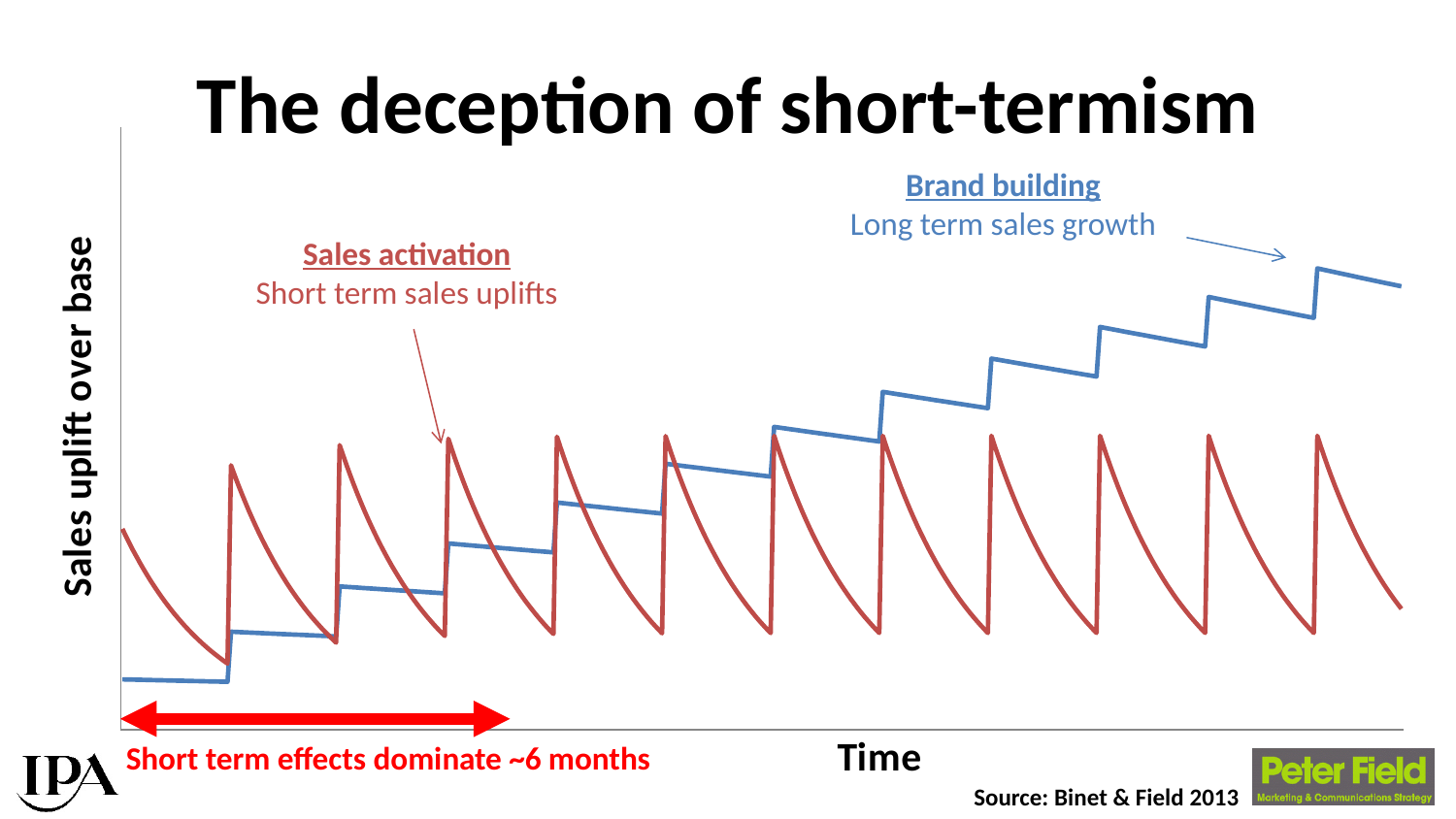
How many series are plotted on the chart? 2 What is the label of the vertical axis? Sales uplift over base What kind of chart is shown on the slide? line chart What is the title of the slide? The deception of short-termism At the right-hand end of the chart, which line is higher: the blue 'Brand building' line or the red 'Sales activation' line? Brand building Do the peaks of the red 'Sales activation' line rise, fall, or stay roughly level over time? rise slightly at first, then stay roughly level How many peaks does the red 'Sales activation' line have? 11 At the far left of the chart, which line starts higher: the red 'Sales activation' line or the blue 'Brand building' line? Sales activation Does the blue 'Brand building' line rise or fall over time? rise